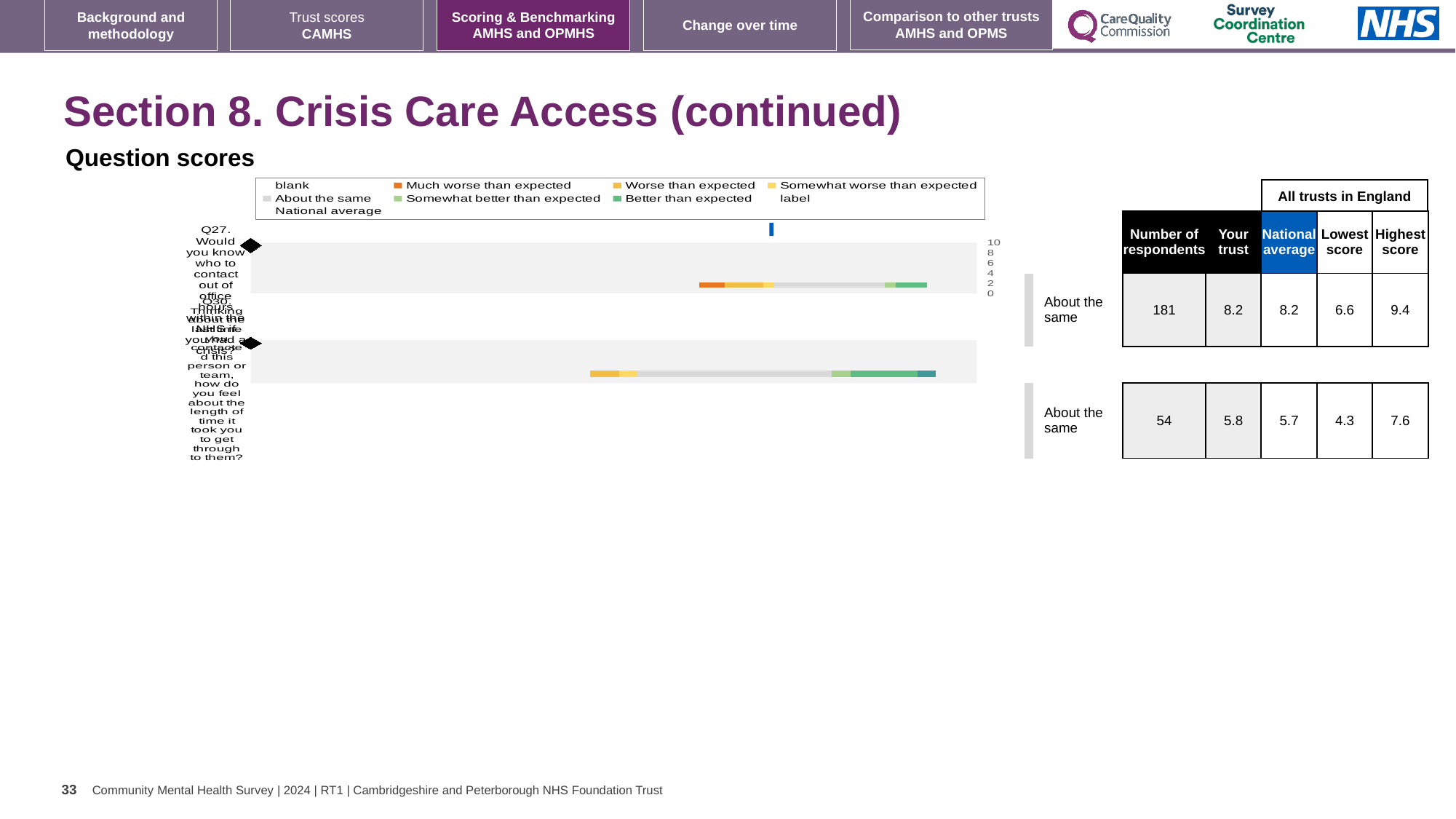
What benchmark category is shown next to the Q27 bar? About the same What is the heading above the question scores chart? Question scores What kind of chart is used to show the question scores on this slide? bar chart In the legend of the question scores chart, what colour represents 'Much worse than expected'? orange In the table beside the chart, what is the 'Your trust' score for Q27? 8.2 For Q30, which is larger in the table: the 'Your trust' score or the national average? Your trust In the table beside the chart, what is the difference between the highest score and the lowest score for Q27? 2.8 How many entries does the legend of the question scores chart list? 9 In the table beside the chart, what is the national average for Q30? 5.7 How many questions (categories) are plotted in the question scores chart? 2 In the table beside the chart, how many respondents are listed for Q27? 181 In the table beside the chart, what is the lowest score for Q30? 4.3